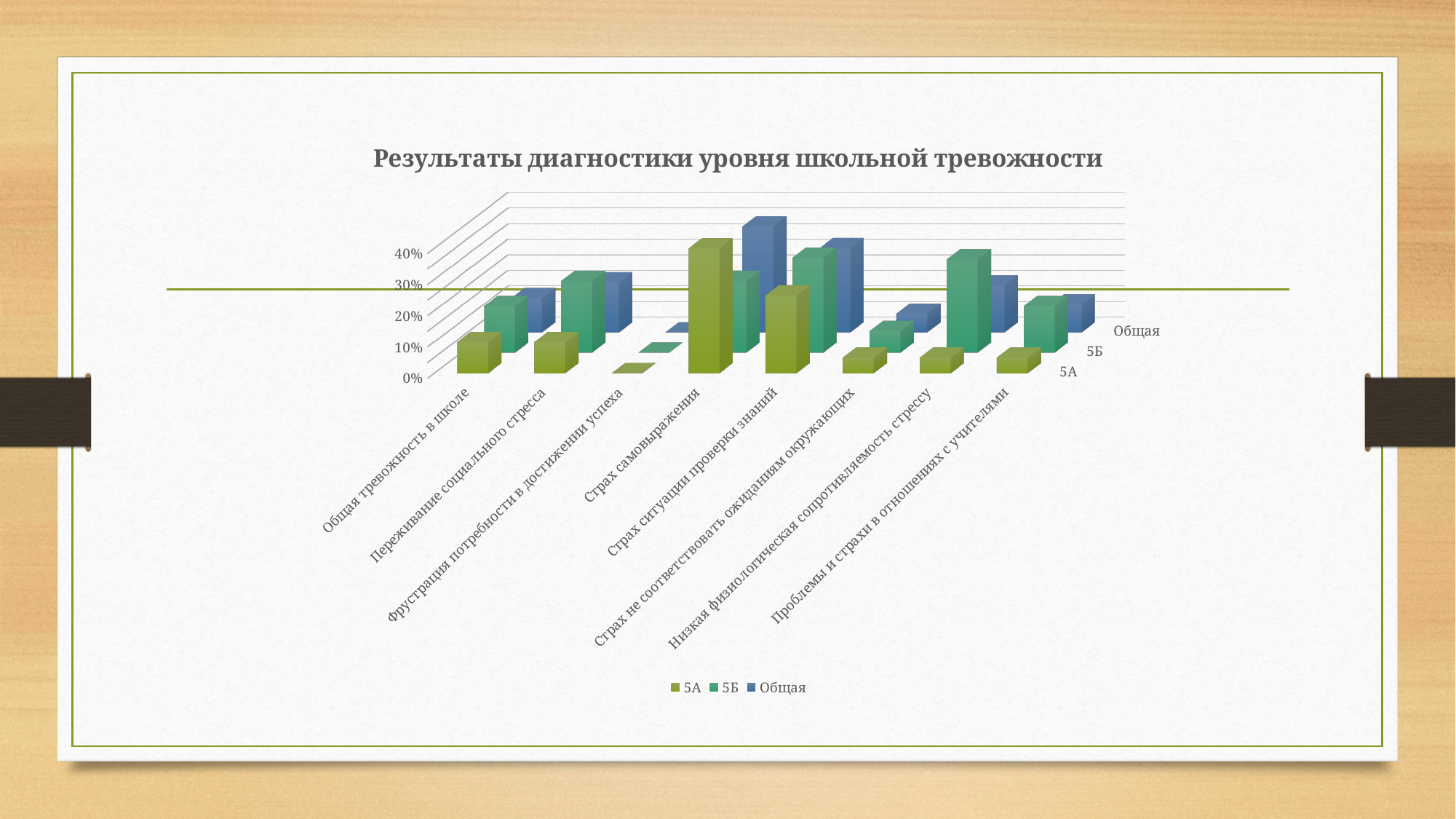
Which is larger for the 5А series: Страх самовыражения or Общая тревожность в школе? Страх самовыражения Which is larger for the 5Б series: Низкая физиологическая сопротивляемость стрессу or Страх не соответствовать ожиданиям окружающих? Низкая физиологическая сопротивляемость стрессу Is the 5А value for Фрустрация потребности в достижении успеха greater or less than 10%? less For the 5Б series, which category has the lowest value? Фрустрация потребности в достижении успеха How many series does the legend list? 3 For the 5А series, which category has the highest value? Страх самовыражения How many categories are shown along the x axis? 8 For the 5А series, which category has the lowest value? Фрустрация потребности в достижении успеха What kind of chart is shown on the slide? Bar chart What is the title of the chart? Результаты диагностики уровня школьной тревожности Is the 5А value for Страх самовыражения greater or less than 20%? greater What are the series names listed in the legend? 5А, 5Б, Общая